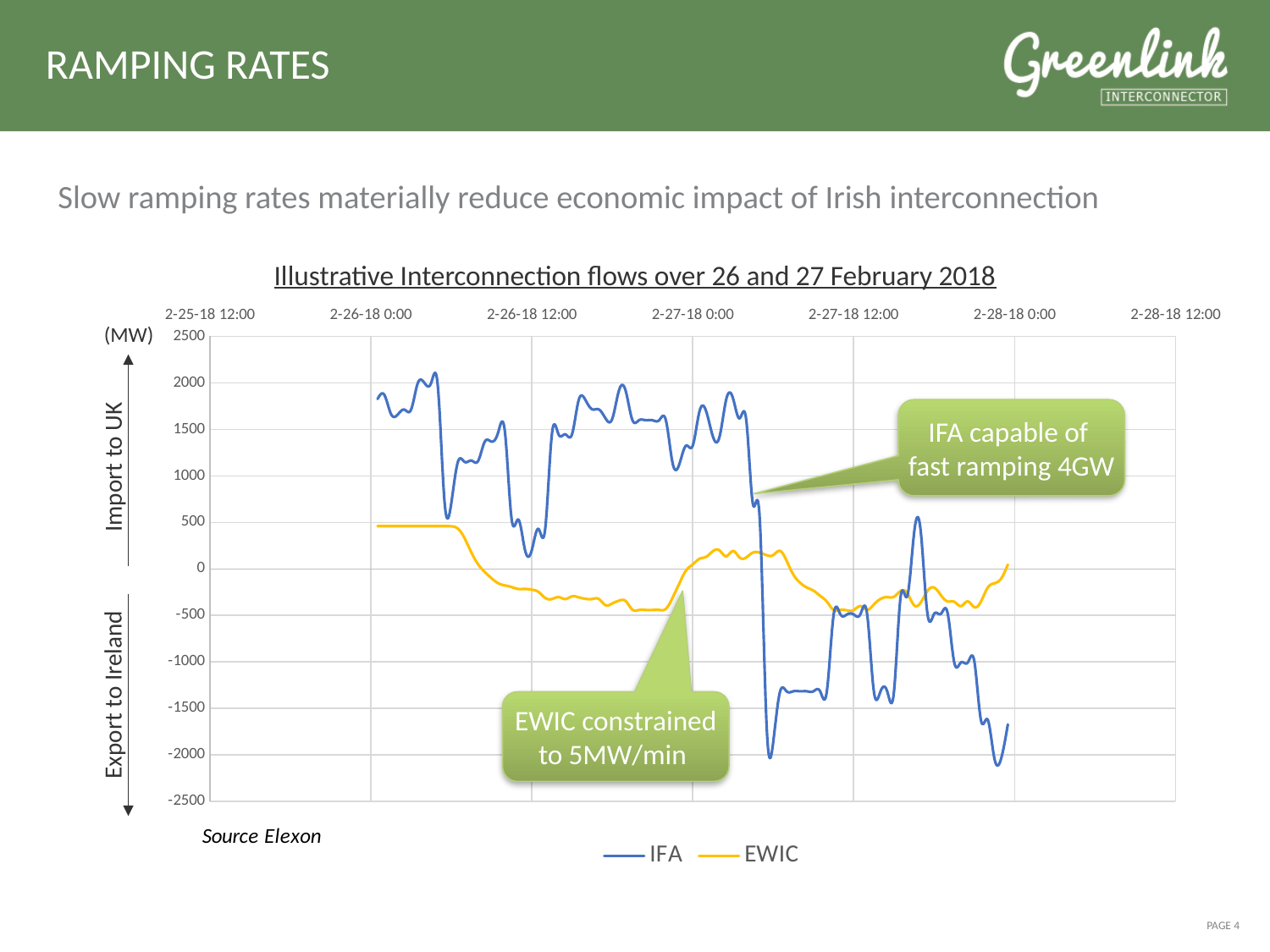
Is the EWIC value at 2-26-18 0:00 greater or less than 0? greater Does the EWIC line rise or fall between 2-26-18 0:00 and 2-26-18 12:00? Fall What are the two series named in the chart legend? IFA and EWIC Is the EWIC value at 2-26-18 12:00 greater or less than 0? less How many series does the chart legend list? 2 Which series reaches the highest value on the chart, IFA or EWIC? IFA Is the IFA value at 2-26-18 0:00 greater or less than 1500? greater What kind of chart is shown on the slide? Line chart Which series reaches the lowest value on the chart, IFA or EWIC? IFA What is the title of the chart? Illustrative Interconnection flows over 26 and 27 February 2018